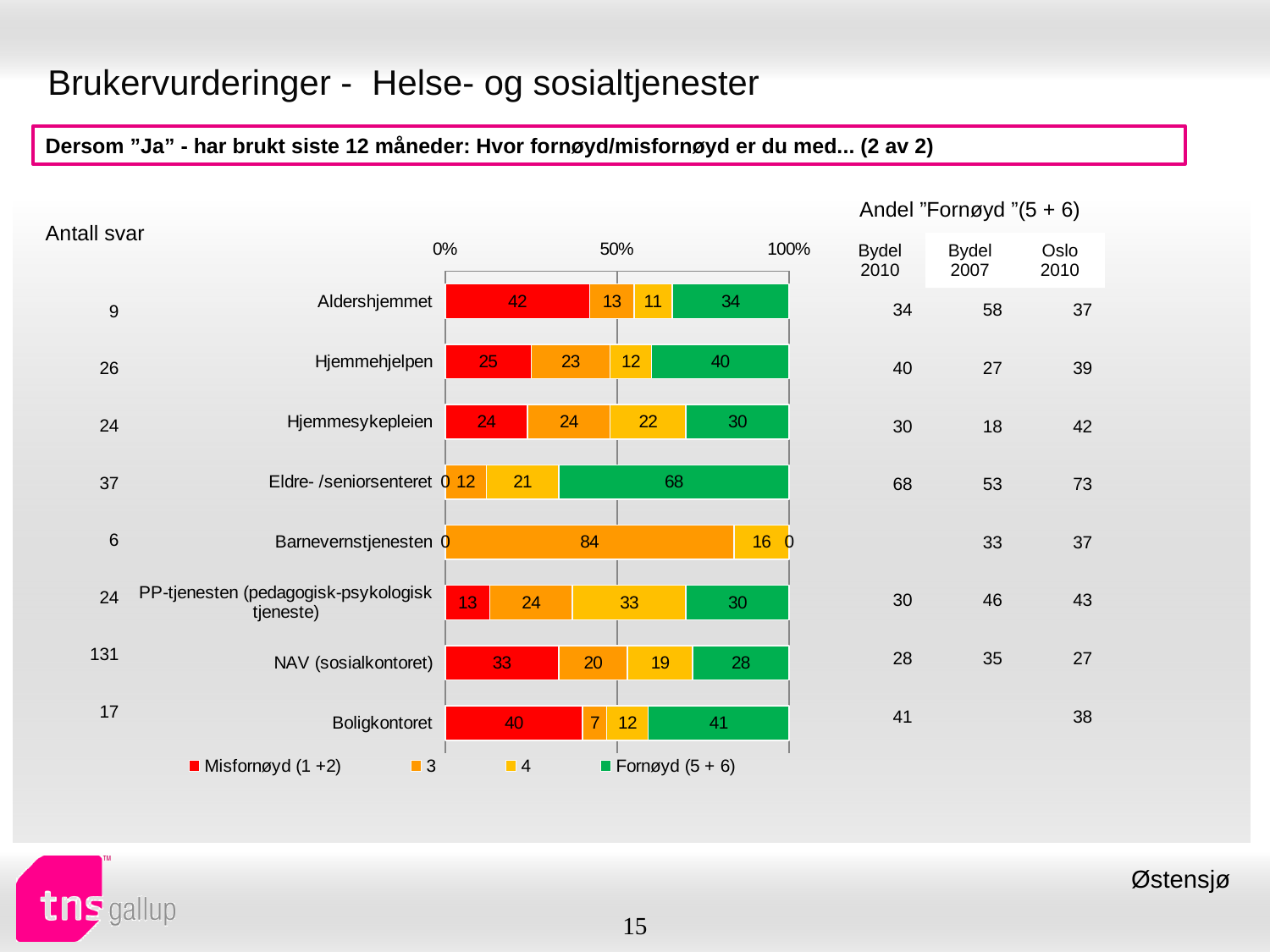
What is the difference between the "Misfornøyd (1 +2)" values for Aldershjemmet and Boligkontoret? 2 What kind of chart is shown on the slide? Stacked bar chart What is the value of the "3" series for Barnevernstjenesten? 84 Which category has the highest "Fornøyd (5 + 6)" value? Eldre- /seniorsenteret How many categories are shown in the chart? 8 Which has the larger "Misfornøyd (1 +2)" value, Aldershjemmet or Hjemmesykepleien? Aldershjemmet Which category has the lowest "Fornøyd (5 + 6)" value? Barnevernstjenesten What is the total of the stacked bar for Hjemmesykepleien? 100 How many series does the legend list? 4 What is the value of the "Fornøyd (5 + 6)" series for Hjemmehjelpen? 40 What is the value of the "Misfornøyd (1 +2)" series for NAV (sosialkontoret)? 33 What is the value of the "4" series for PP-tjenesten (pedagogisk-psykologisk tjeneste)? 33